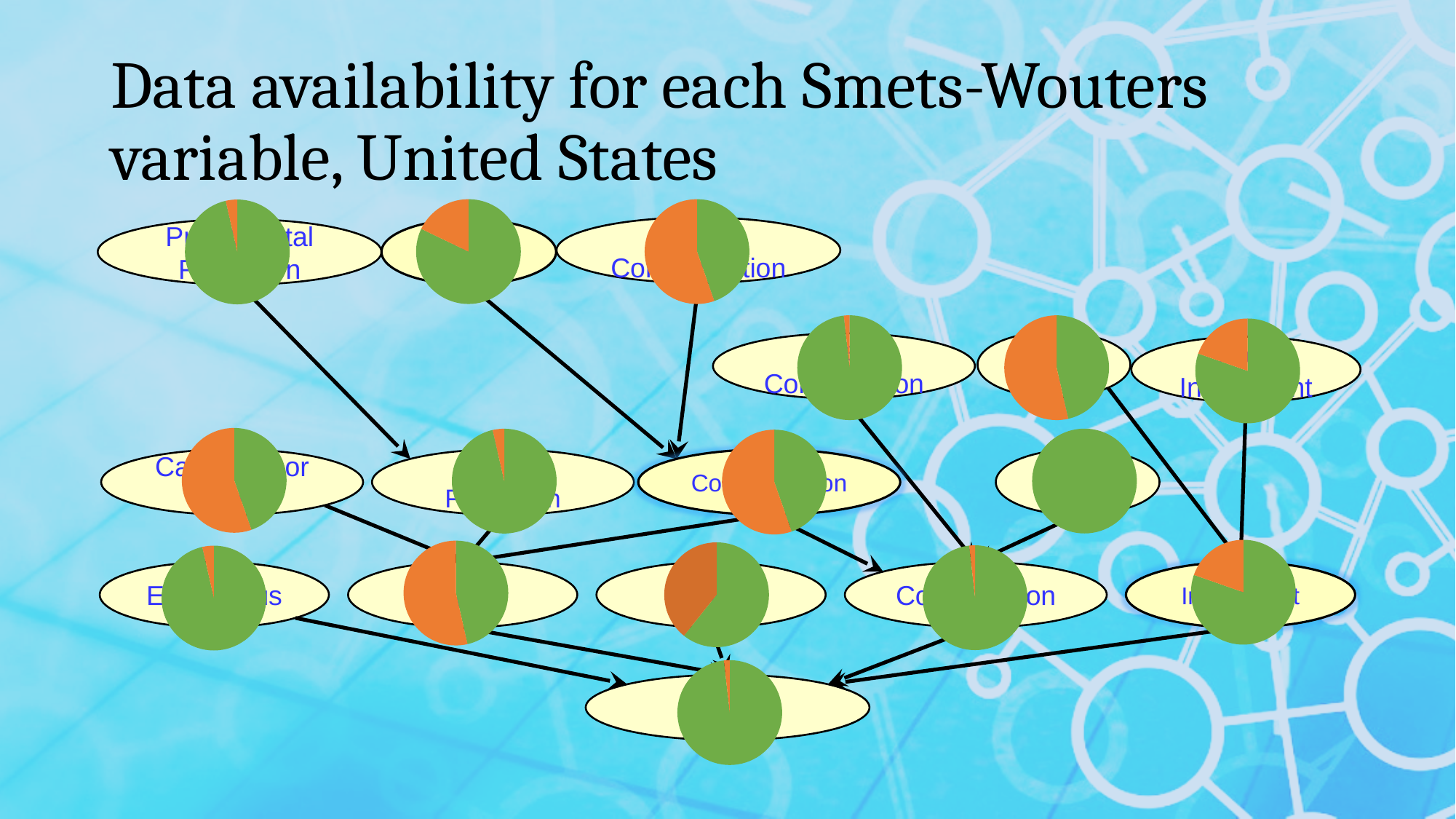
What is the title of the slide containing the pie charts? Data availability for each Smets-Wouters variable, United States How many pie charts are shown in the bottom-most row of the diagram (the single oval at the bottom centre)? 1 What two colours are used for the slices in the pie charts? green and orange In the pie chart at the bottom centre of the slide, which slice is larger, green or orange? green What kind of chart is used repeatedly on this slide? pie chart In the pie chart over the 'Investment' oval in the second row on the right, which slice is larger, green or orange? green In the top-left pie chart, which slice is larger, green or orange? green How many pie charts are shown in the top row of the diagram? 3